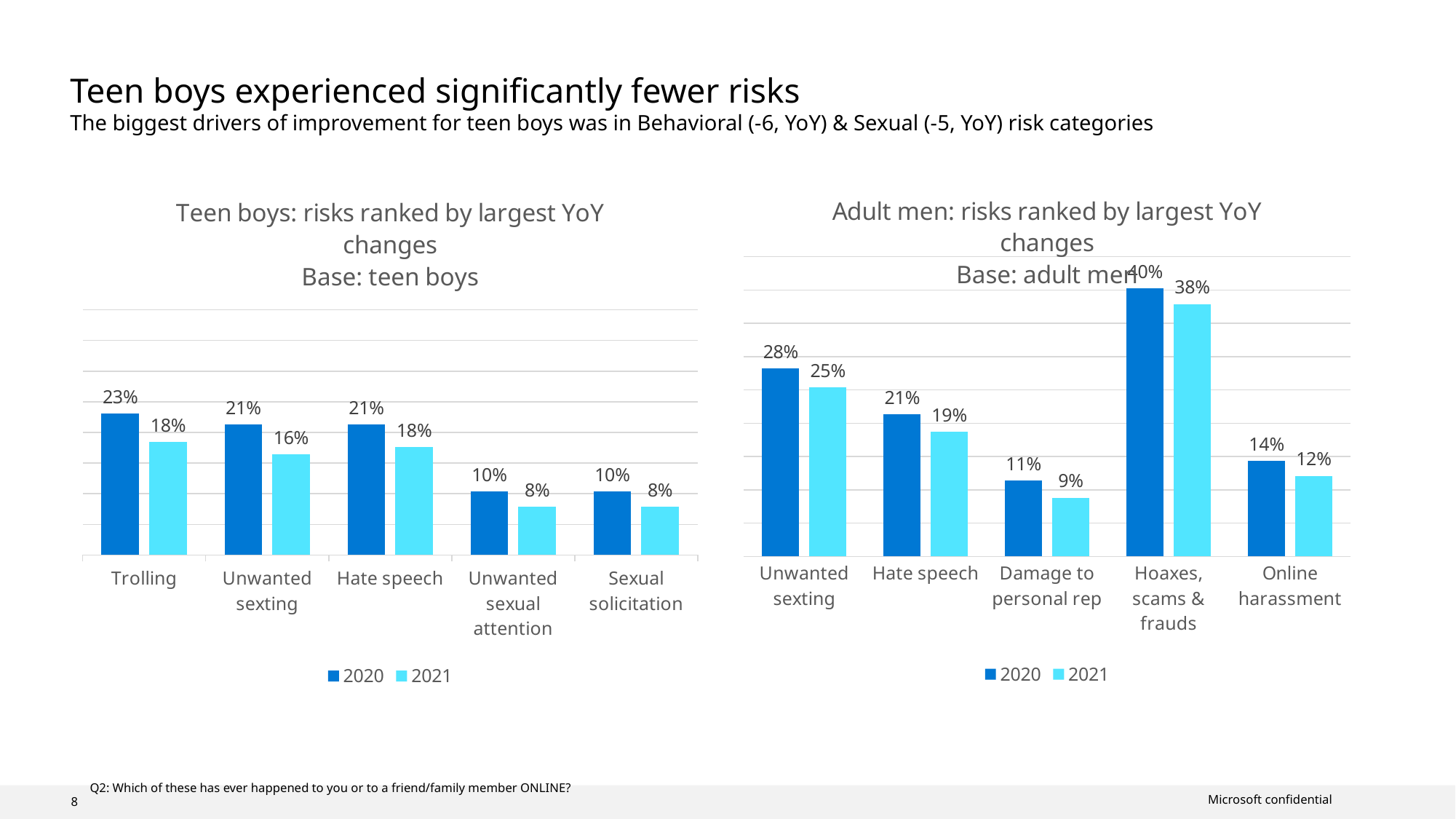
In the 'Teen boys: risks ranked by largest YoY changes' chart, what is the 2021 value for Unwanted sexting? 16% In the 'Adult men: risks ranked by largest YoY changes' chart, which category has the lowest 2021 value? Damage to personal rep What type of chart is the 'Teen boys: risks ranked by largest YoY changes' chart? Bar chart In the 'Adult men: risks ranked by largest YoY changes' chart, what is the difference between the 2020 and 2021 values for Unwanted sexting? 3% In the 'Teen boys: risks ranked by largest YoY changes' chart, what is the difference between the 2020 and 2021 values for Trolling? 5% How many series does the legend of the 'Adult men: risks ranked by largest YoY changes' chart list? 2 In the 'Teen boys: risks ranked by largest YoY changes' chart, what is the 2020 value for Trolling? 23% In the 'Adult men: risks ranked by largest YoY changes' chart, what is the 2021 value for Hoaxes, scams & frauds? 38% In the 'Teen boys: risks ranked by largest YoY changes' chart, which category has the highest 2020 value? Trolling In the 'Adult men: risks ranked by largest YoY changes' chart, what is the 2020 value for Damage to personal rep? 11% How many risk categories are shown in the 'Teen boys: risks ranked by largest YoY changes' chart? 5 In the 'Adult men: risks ranked by largest YoY changes' chart, which is larger: the 2020 value for Online harassment or the 2021 value for Hate speech? 2021 value for Hate speech